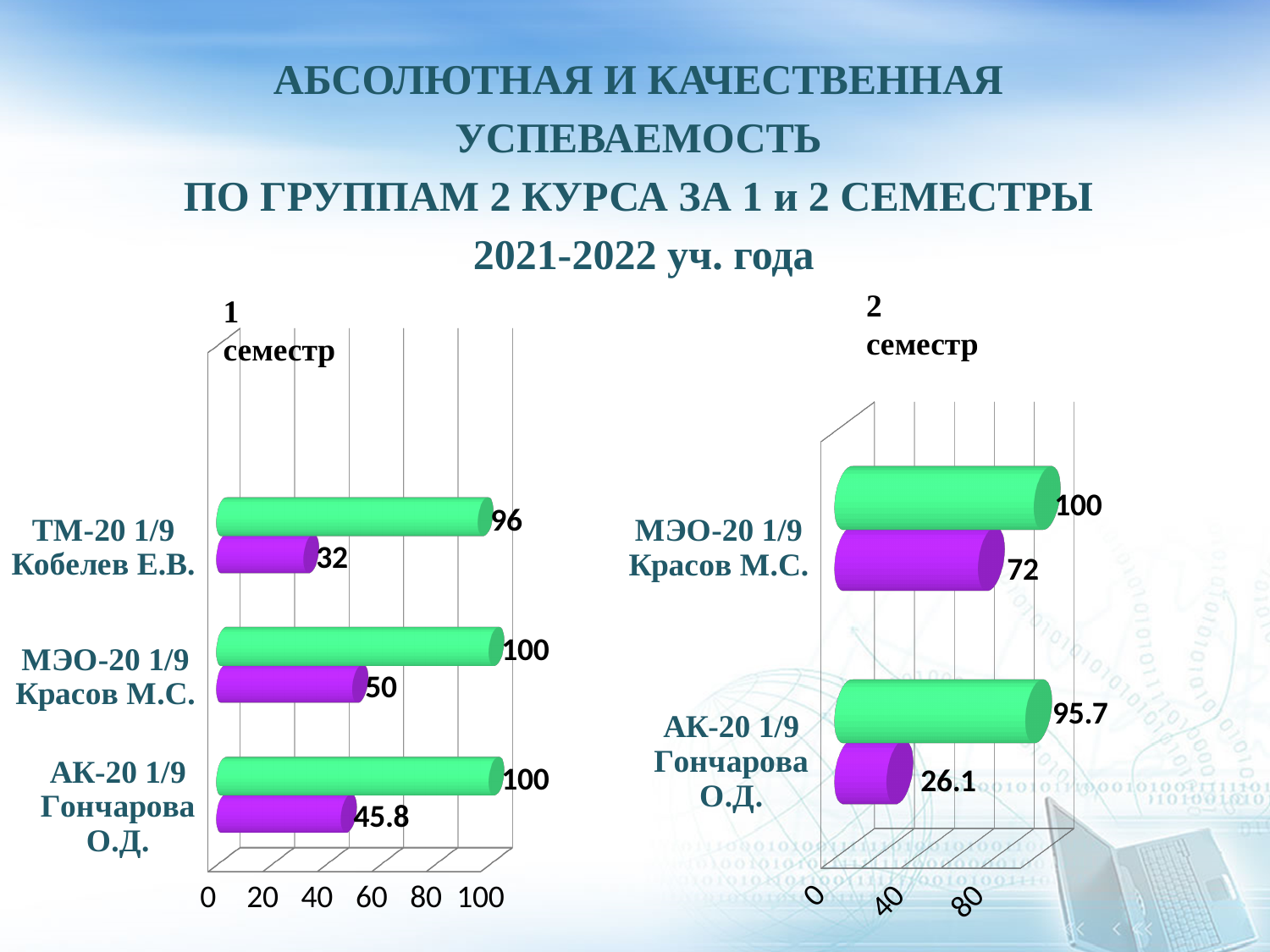
In the "1 семестр" chart, what is the value of the green bar for ТМ-20 1/9 Кобелев Е.В.? 96 In the "1 семестр" chart, how many groups are shown? 3 In the "2 семестр" chart, what is the value of the purple bar for МЭО-20 1/9 Красов М.С.? 72 In the "2 семестр" chart, how many groups are shown? 2 In the "2 семестр" chart, which group has the higher purple bar value? МЭО-20 1/9 Красов М.С. In the "1 семестр" chart, what is the value of the purple bar for АК-20 1/9 Гончарова О.Д.? 45.8 In the "2 семестр" chart, what is the value of the green bar for АК-20 1/9 Гончарова О.Д.? 95.7 In the "1 семестр" chart, what is the difference between the green and purple bar values for ТМ-20 1/9 Кобелев Е.В.? 64 In the "1 семестр" chart, which group has the lowest purple bar value? ТМ-20 1/9 Кобелев Е.В. What type of chart is the "1 семестр" chart? Bar chart In the "2 семестр" chart, what is the difference between the green and purple bar values for АК-20 1/9 Гончарова О.Д.? 69.6 In the "1 семестр" chart, what is the value of the purple bar for МЭО-20 1/9 Красов М.С.? 50